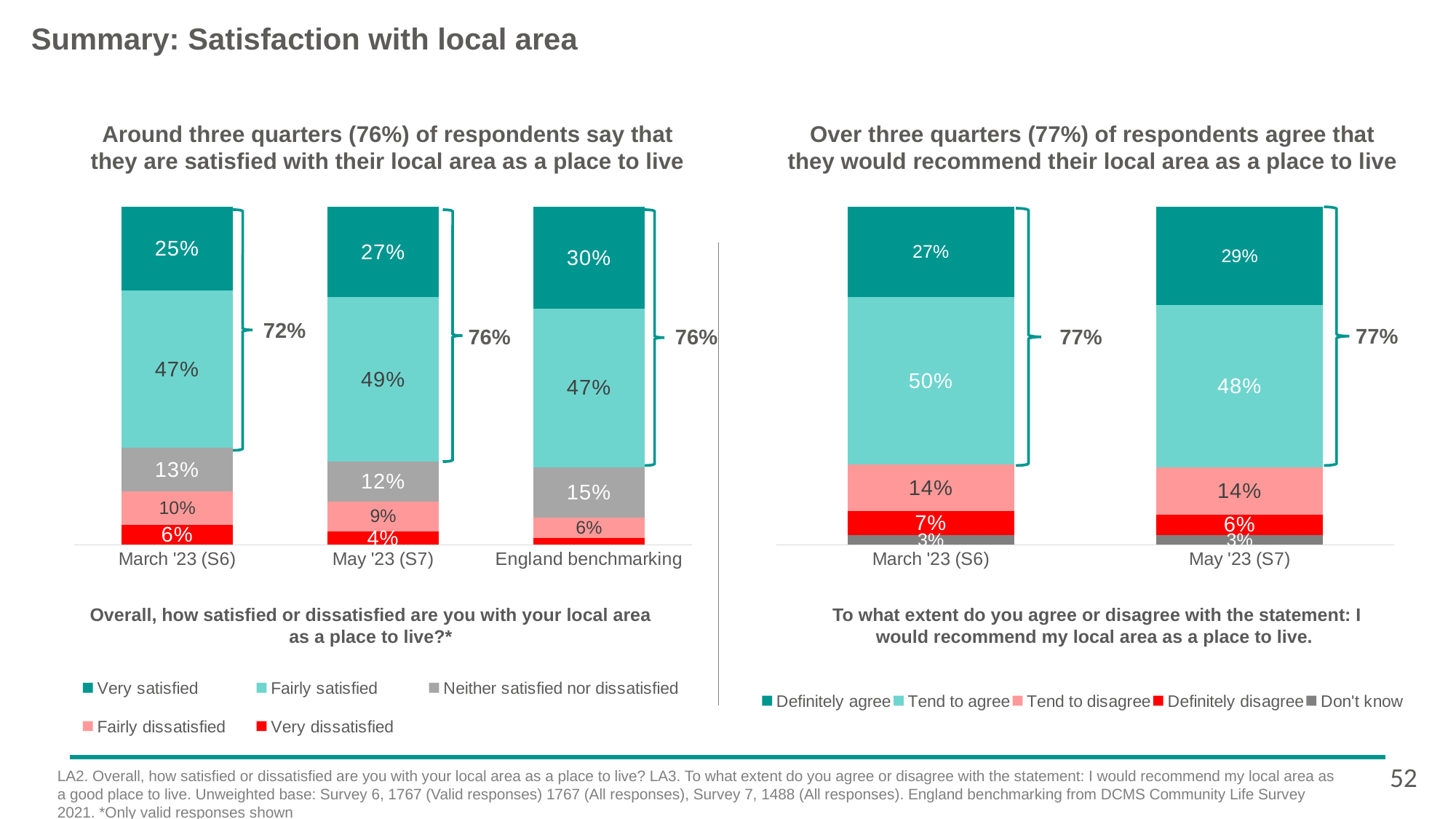
In the left chart (satisfaction with local area), what percentage of respondents were very satisfied in May '23 (S7)? 27% What type of chart is used on the right side of the slide (recommend local area)? Stacked bar chart In the left chart (satisfaction with local area), what is the difference between the 'Neither satisfied nor dissatisfied' values for England benchmarking and May '23 (S7)? 3 percentage points In the right chart (recommend local area), which bar has the larger 'Definitely agree' value, March '23 (S6) or May '23 (S7)? May '23 (S7) In the left chart (satisfaction with local area), how many series does the legend list? 5 In the right chart (recommend local area), what percentage said 'Definitely disagree' in May '23 (S7)? 6% In the right chart (recommend local area), what is the combined agree percentage shown by the bracket for May '23 (S7)? 77% In the right chart (recommend local area), what percentage of respondents said 'Tend to agree' in March '23 (S6)? 50% In the left chart (satisfaction with local area), which bar has the highest 'Very satisfied' percentage? England benchmarking In the left chart (satisfaction with local area), what is the combined satisfied percentage shown by the bracket for March '23 (S6)? 72% In the left chart (satisfaction with local area), what percentage were fairly satisfied in the England benchmarking bar? 47% In the left chart (satisfaction with local area), how many bars are plotted? 3